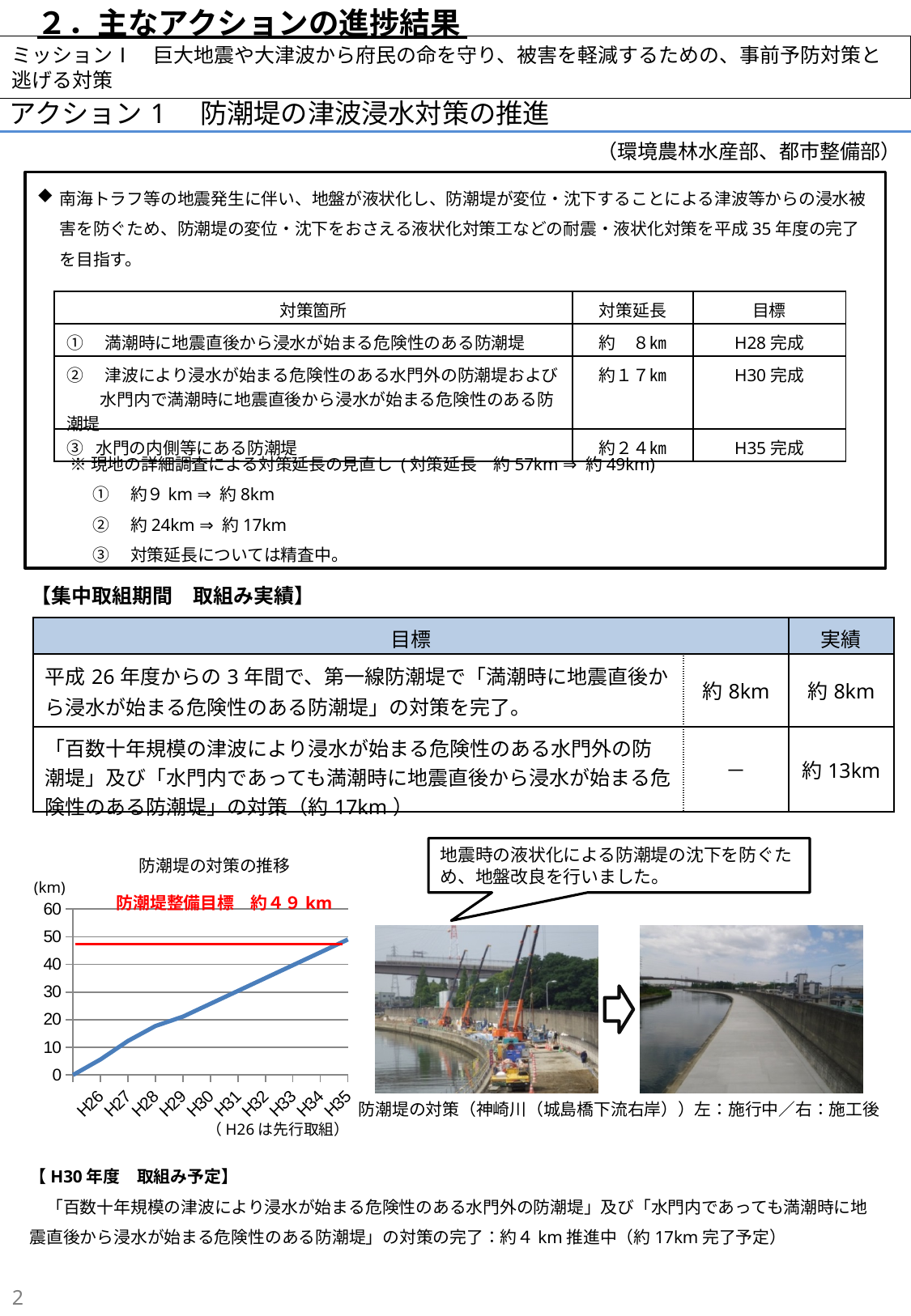
In the 防潮堤の対策の推移 chart, is the value for H32 greater or less than 30? greater In the 防潮堤の対策の推移 chart, is the value for H28 greater or less than 20? less What unit is shown on the y axis of the 防潮堤の対策の推移 chart? km In the 防潮堤の対策の推移 chart, is the value for H30 greater or less than 20? greater What target value is written in red above the 防潮堤の対策の推移 chart? 約49km In the 防潮堤の対策の推移 chart, which year has the highest value? H35 In the 防潮堤の対策の推移 chart, which year has the lowest value? H26 In the 防潮堤の対策の推移 chart, do the values rise or fall from H26 to H35? rise In the 防潮堤の対策の推移 chart, how many fiscal years are shown on the x axis? 10 In the 防潮堤の対策の推移 chart, which is larger, the value for H34 or the value for H28? H34 What kind of chart is the 防潮堤の対策の推移 chart? line chart